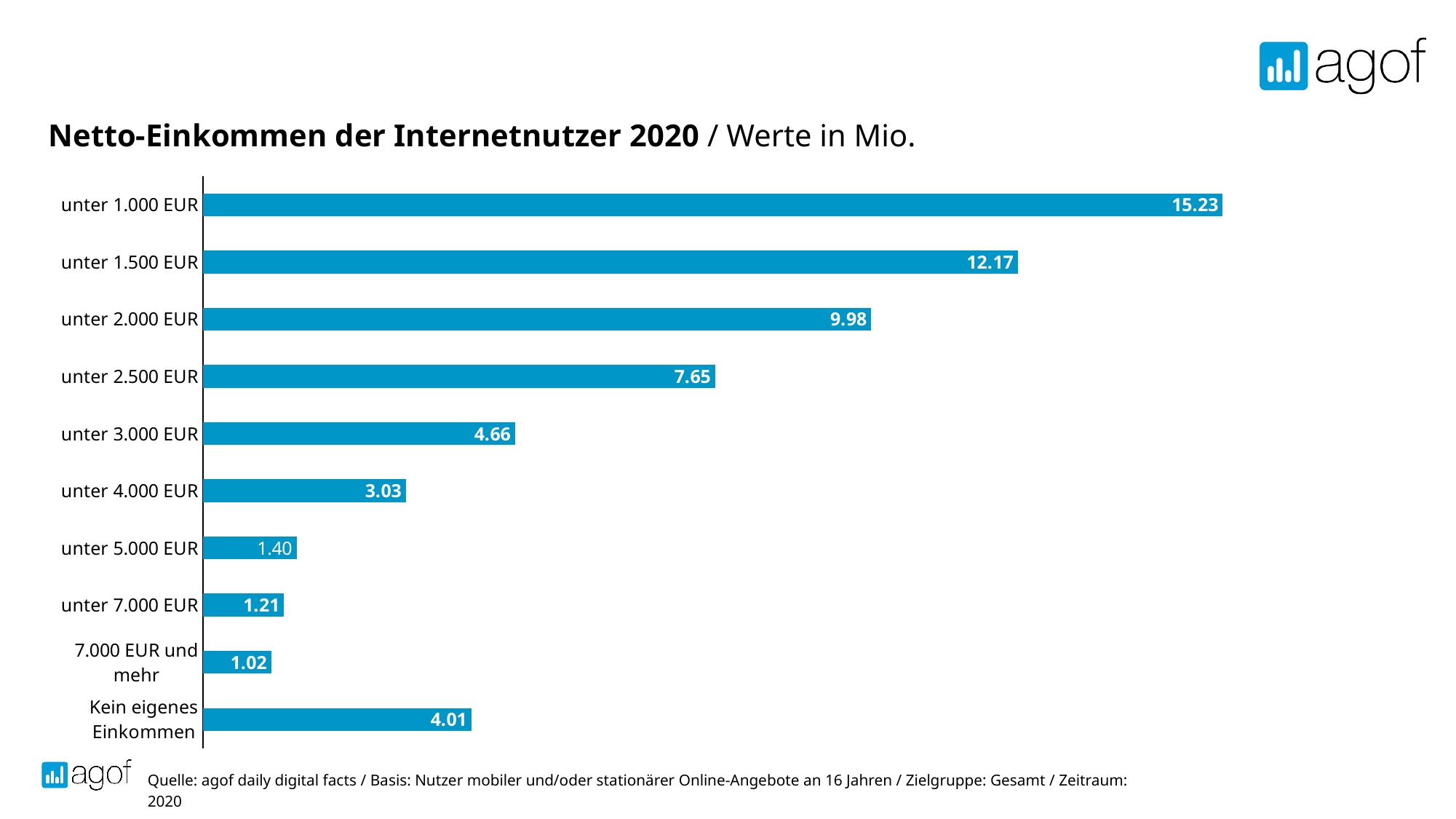
Which is larger, the value for "unter 4.000 EUR" or the value for "Kein eigenes Einkommen"? Kein eigenes Einkommen What is the value for "unter 1.000 EUR"? 15.23 What kind of chart is shown on the slide? Bar chart What is the value for "unter 3.000 EUR"? 4.66 What is the difference between the values for "unter 2.000 EUR" and "unter 2.500 EUR"? 2.33 How many categories are shown in the chart? 10 Which category has the highest value? unter 1.000 EUR What is the value for "Kein eigenes Einkommen"? 4.01 What is the difference between the values for "unter 1.000 EUR" and "unter 1.500 EUR"? 3.06 What is the title of the chart? Netto-Einkommen der Internetnutzer 2020 / Werte in Mio. Which category has the lowest value? 7.000 EUR und mehr What is the value for "7.000 EUR und mehr"? 1.02